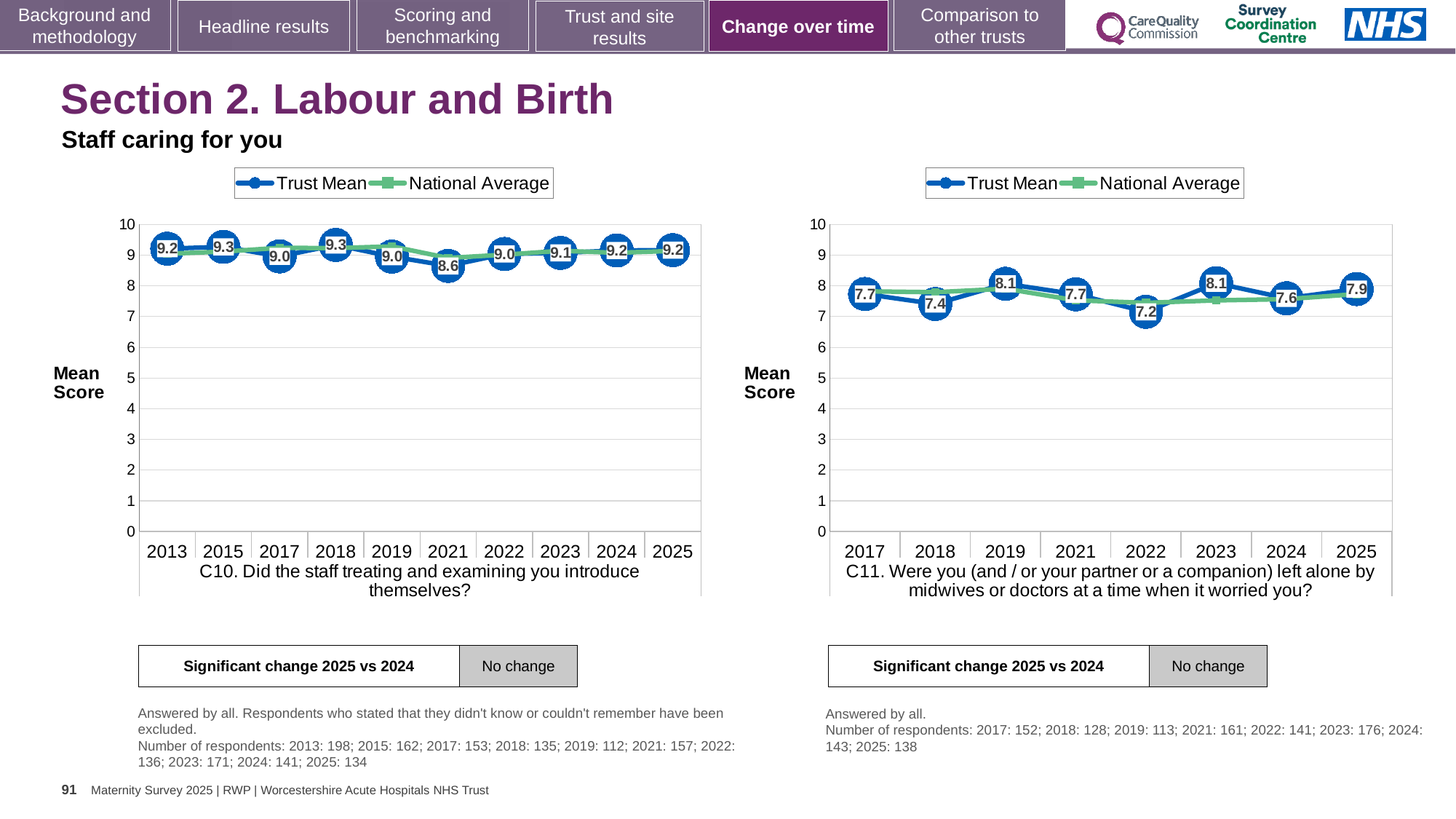
How many series does the legend of the C11 chart on the right list? 2 How many years are plotted in the C10 chart on the left? 10 In the C10 chart on the left, what is the difference between the Trust Mean scores for 2025 and 2021? 0.6 In the C10 chart on the left, which year has the lowest Trust Mean score? 2021 In the C11 chart on the right, which year has the higher Trust Mean score, 2018 or 2019? 2019 In the C11 chart on the right, what is the Trust Mean score for 2022? 7.2 In the C11 chart on the right, which year has the lowest Trust Mean score? 2022 In the C10 chart on the left, what is the Trust Mean score for 2021? 8.6 How many years are plotted in the C11 chart on the right? 8 In the C11 chart on the right, what is the difference between the Trust Mean scores for 2023 and 2022? 0.9 In the C10 chart on the left, is the National Average value for 2021 greater or less than 8? greater What kind of chart is the C10 chart on the left? Line chart